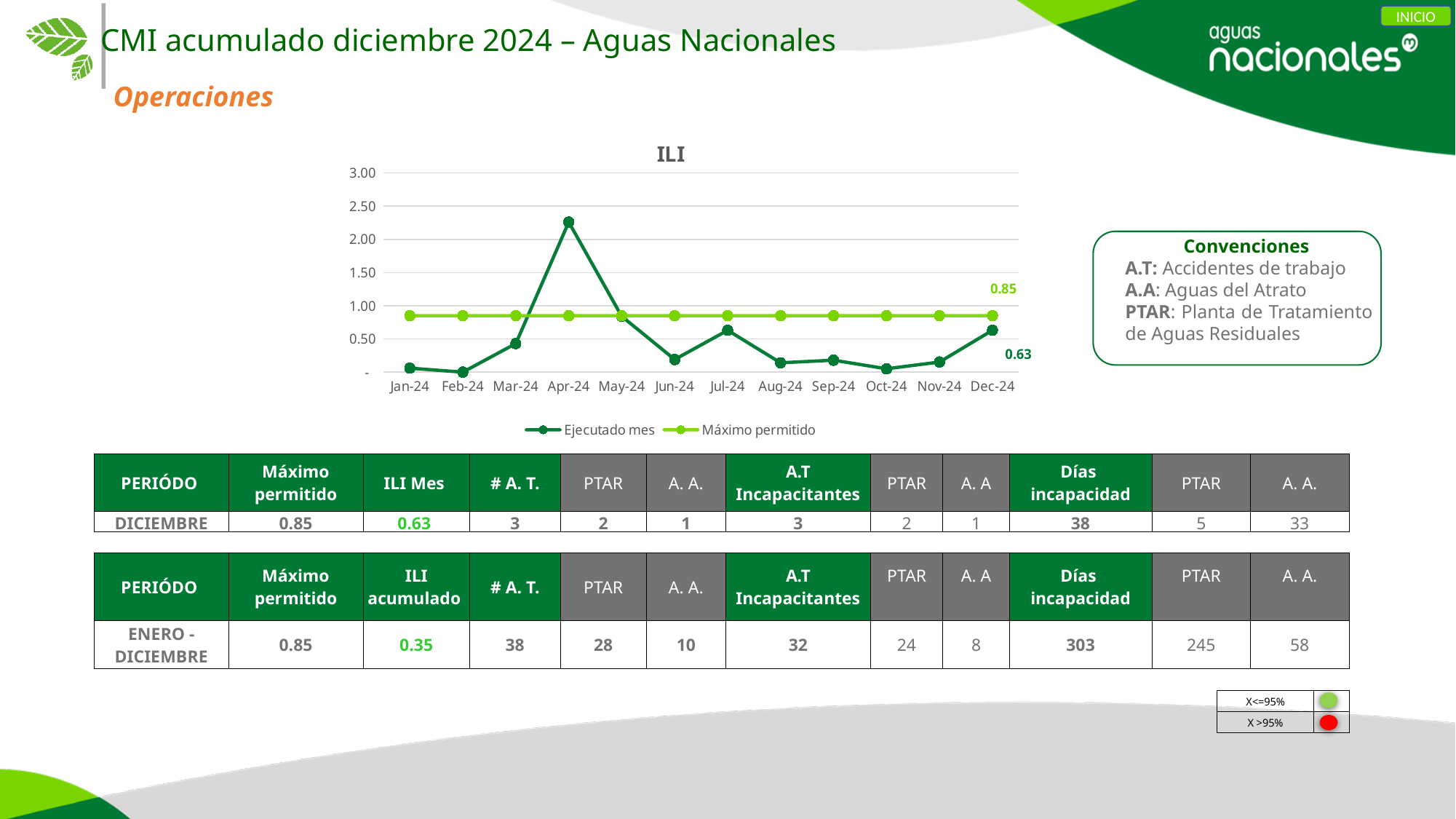
Does the Ejecutado mes series rise or fall from Apr-24 to Jun-24? fall What is the difference between the Máximo permitido value (0.85) and the Ejecutado mes value (0.63) for Dec-24? 0.22 What is the Ejecutado mes value for Dec-24 in the ILI chart? 0.63 How many series does the legend of the ILI chart list? 2 In which month does the Ejecutado mes series reach its highest value in the ILI chart? Apr-24 What kind of chart is the ILI chart? line chart How many months are plotted on the x axis of the ILI chart? 12 For Dec-24, which series has the larger value in the ILI chart: Ejecutado mes or Máximo permitido? Máximo permitido What is the Máximo permitido value shown for Dec-24 in the ILI chart? 0.85 Which is larger in the ILI chart: the Ejecutado mes value for Apr-24 or for Jul-24? Apr-24 Is the Ejecutado mes value for Apr-24 greater or less than 2.00? greater Is the Ejecutado mes value for Jun-24 greater or less than 0.50? less